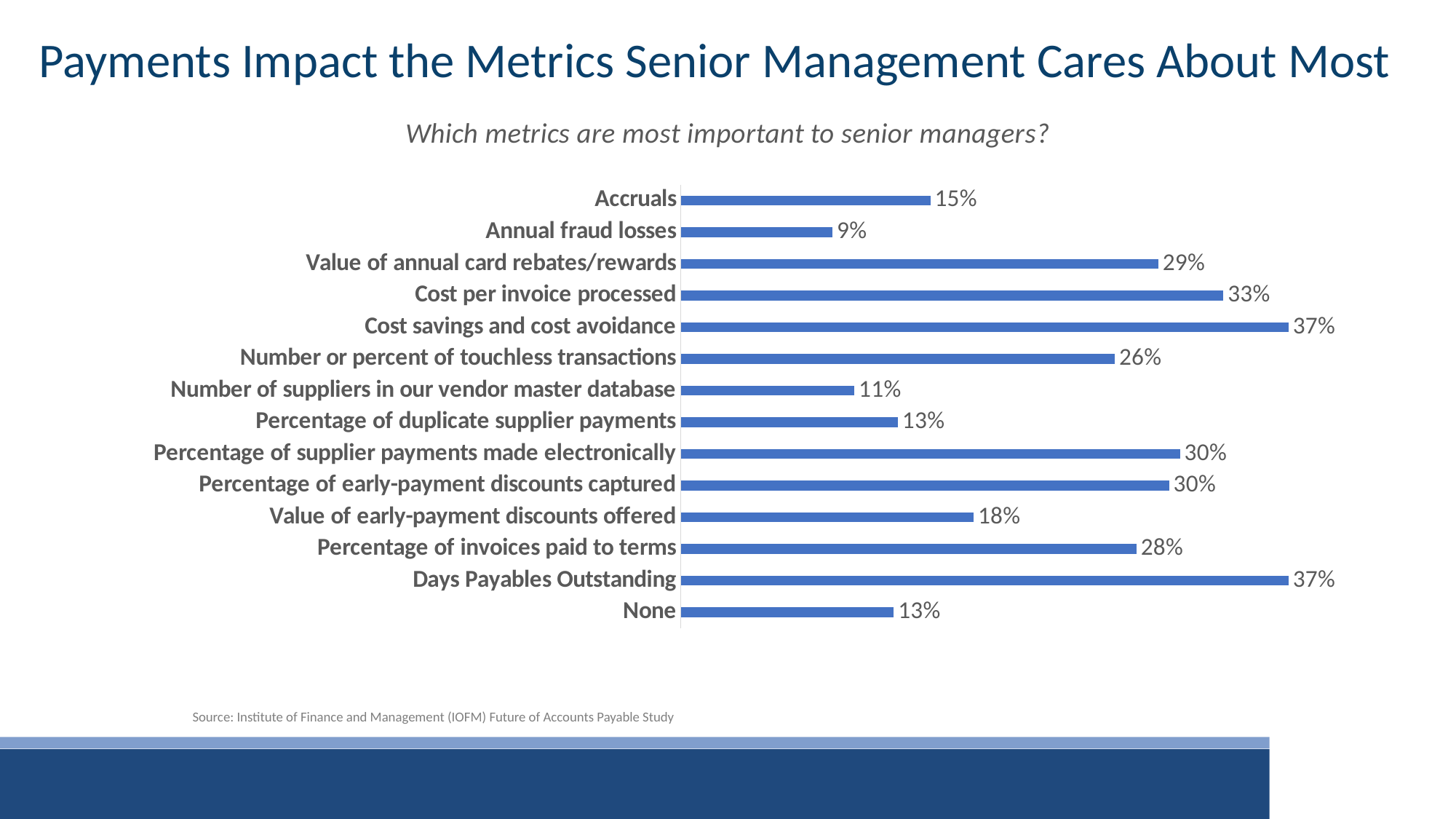
What is the difference between Cost savings and cost avoidance and Value of annual card rebates/rewards? 8% What kind of chart is shown on the slide? Bar chart What is the value for Percentage of invoices paid to terms? 28% What is the difference between Value of early-payment discounts offered and Percentage of duplicate supplier payments? 5% What is the value for Accruals? 15% Which metric has the lowest value? Annual fraud losses What question is shown as the chart's subtitle? Which metrics are most important to senior managers? Which is larger, Annual fraud losses or None? None What is the value for Number of suppliers in our vendor master database? 11% Which is larger, Number or percent of touchless transactions or Accruals? Number or percent of touchless transactions How many metrics are plotted in the chart? 14 What is the value for Cost per invoice processed? 33%